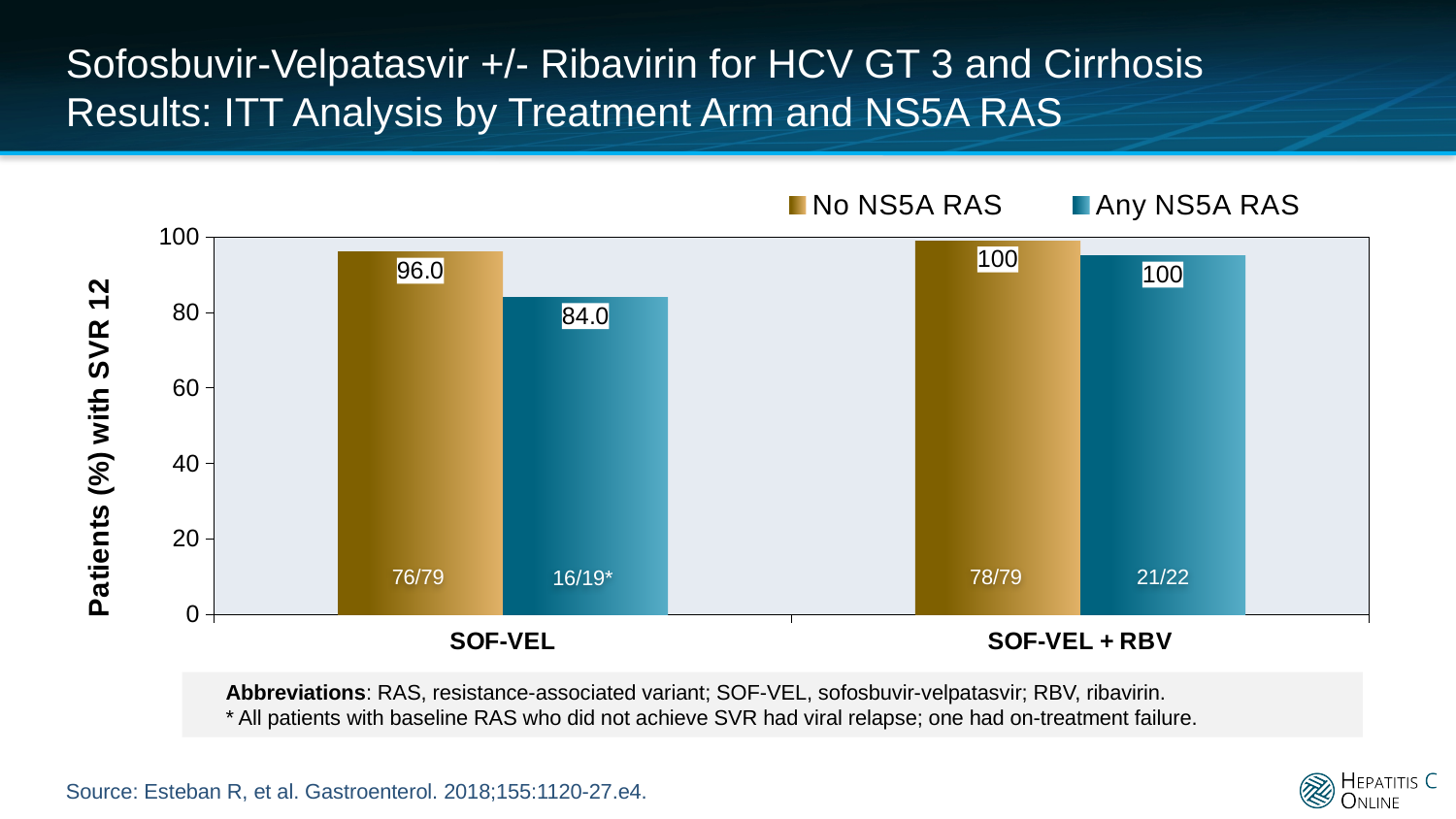
What is the label of the y axis? Patients (%) with SVR 12 What kind of chart is shown on the slide? bar chart In the SOF-VEL arm, which group has the higher SVR 12 rate, No NS5A RAS or Any NS5A RAS? No NS5A RAS What fraction of patients is printed on the Any NS5A RAS bar in the SOF-VEL arm? 16/19* What fraction of patients is printed on the No NS5A RAS bar in the SOF-VEL + RBV arm? 78/79 What is the SVR 12 rate shown for the Any NS5A RAS group in the SOF-VEL arm? 84.0 What is the SVR 12 rate shown for the No NS5A RAS group in the SOF-VEL arm? 96.0 How many treatment arms are shown on the x axis? 2 How many series does the legend list? 2 Which bar has the lowest SVR 12 rate on the chart? Any NS5A RAS in the SOF-VEL arm Is the SVR 12 rate for the Any NS5A RAS group in the SOF-VEL arm greater or less than 80? greater What is the difference in SVR 12 rate between the No NS5A RAS and Any NS5A RAS groups in the SOF-VEL arm? 12.0